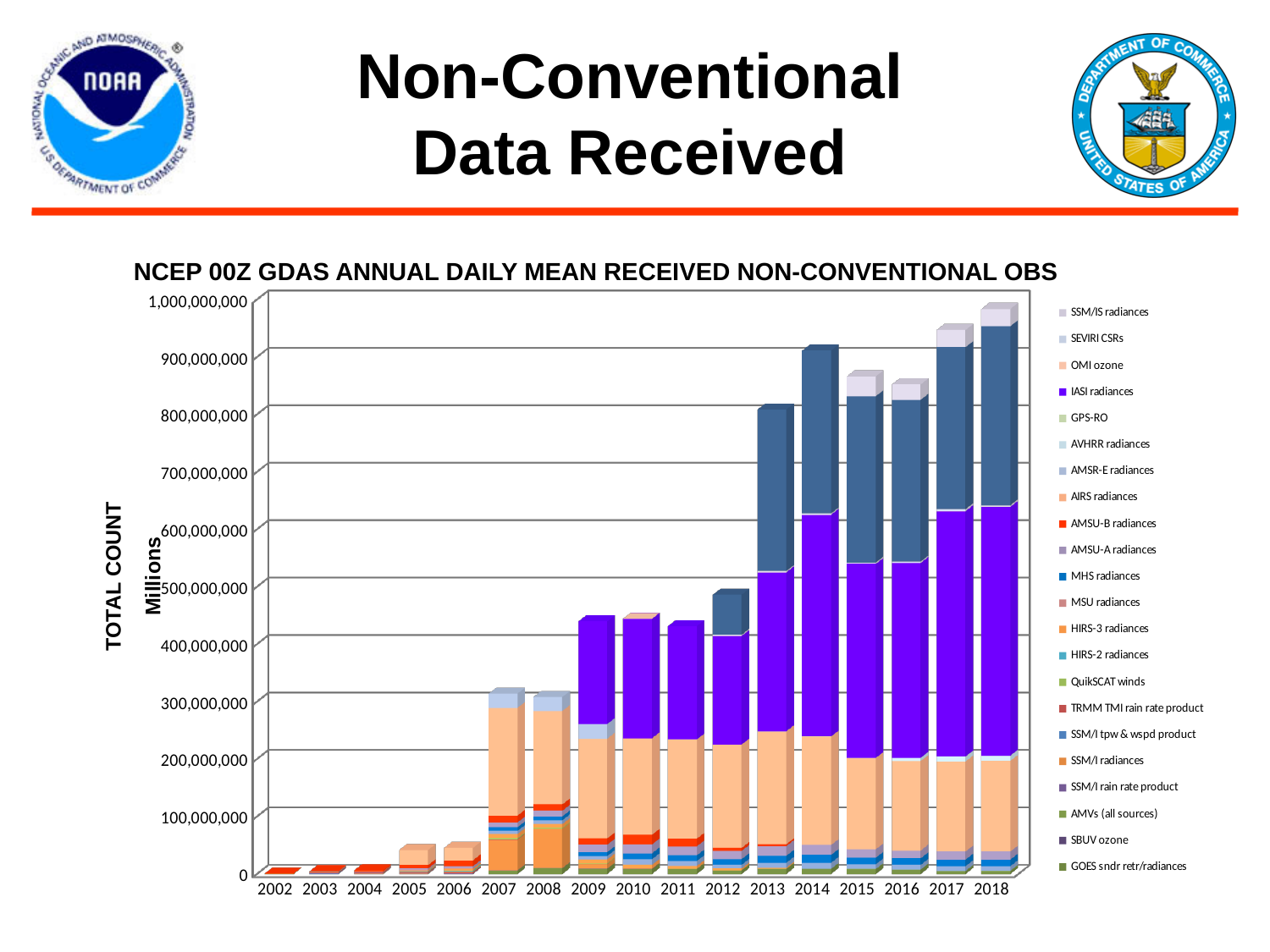
Which year has the larger total count, 2016 or 2017? 2017 Is the total for 2013 greater or less than 700,000,000? greater Do the total counts generally rise or fall from 2002 to 2018? Rise Is the total for 2005 greater or less than 100,000,000? less Which year has the highest total count in the chart? 2018 What is the title of the chart? NCEP 00Z GDAS ANNUAL DAILY MEAN RECEIVED NON-CONVENTIONAL OBS What kind of chart is shown on the slide? Stacked bar chart Is the total for 2012 greater or less than 500,000,000? less Which year has the larger total count, 2012 or 2013? 2013 How many series does the chart's legend list? 22 How many years are shown along the x axis of the chart? 17